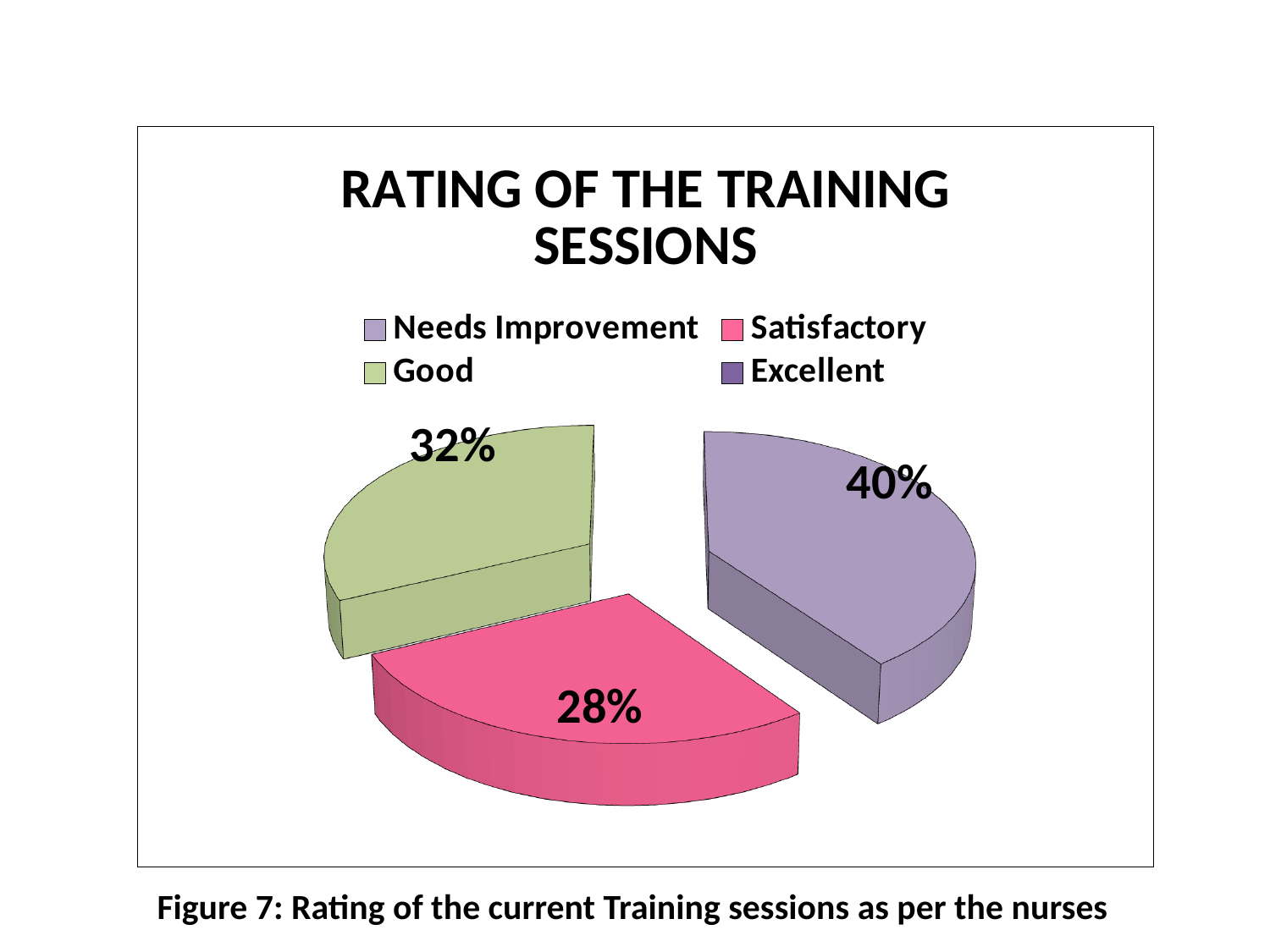
How many slices are visible in the pie? 3 What is the difference in percentage points between the Needs Improvement slice and the Satisfactory slice? 12 What percentage of the pie is labelled for Satisfactory? 28% Which slice is larger, Good or Satisfactory? Good How many entries does the legend list? 4 What percentage of the pie is labelled for Good? 32% What kind of chart is shown on the slide? pie chart What colour is the Satisfactory slice? pink Which category has the largest slice of the pie? Needs Improvement What is the title of the chart? RATING OF THE TRAINING SESSIONS Which of the visible slices is the smallest? Satisfactory What percentage of the pie is labelled for Needs Improvement? 40%